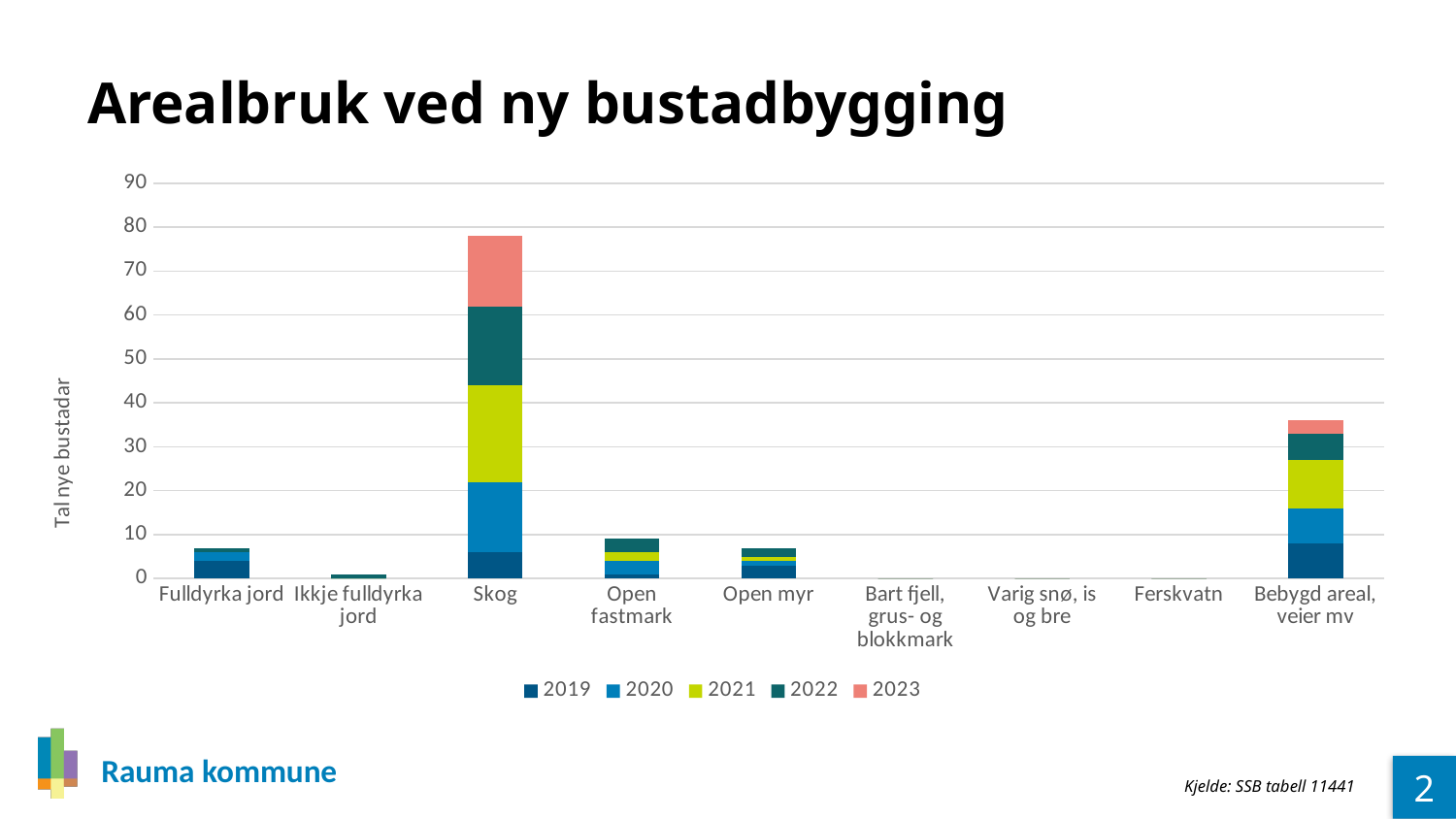
What is the title of the chart? Arealbruk ved ny bustadbygging Is the total value for Bebygd areal, veier mv greater or less than 40? less Which has the larger total, Skog or Bebygd areal, veier mv? Skog How many categories are shown on the x axis? 9 Is the total value for Fulldyrka jord greater or less than 10? less Which has the larger total, Open fastmark or Bebygd areal, veier mv? Bebygd areal, veier mv What is the label on the y axis? Tal nye bustadar How many series does the legend list? 5 Is the total value for Skog greater or less than 70? greater Which category has the highest total stacked bar? Skog What kind of chart is shown on the slide? Stacked bar chart